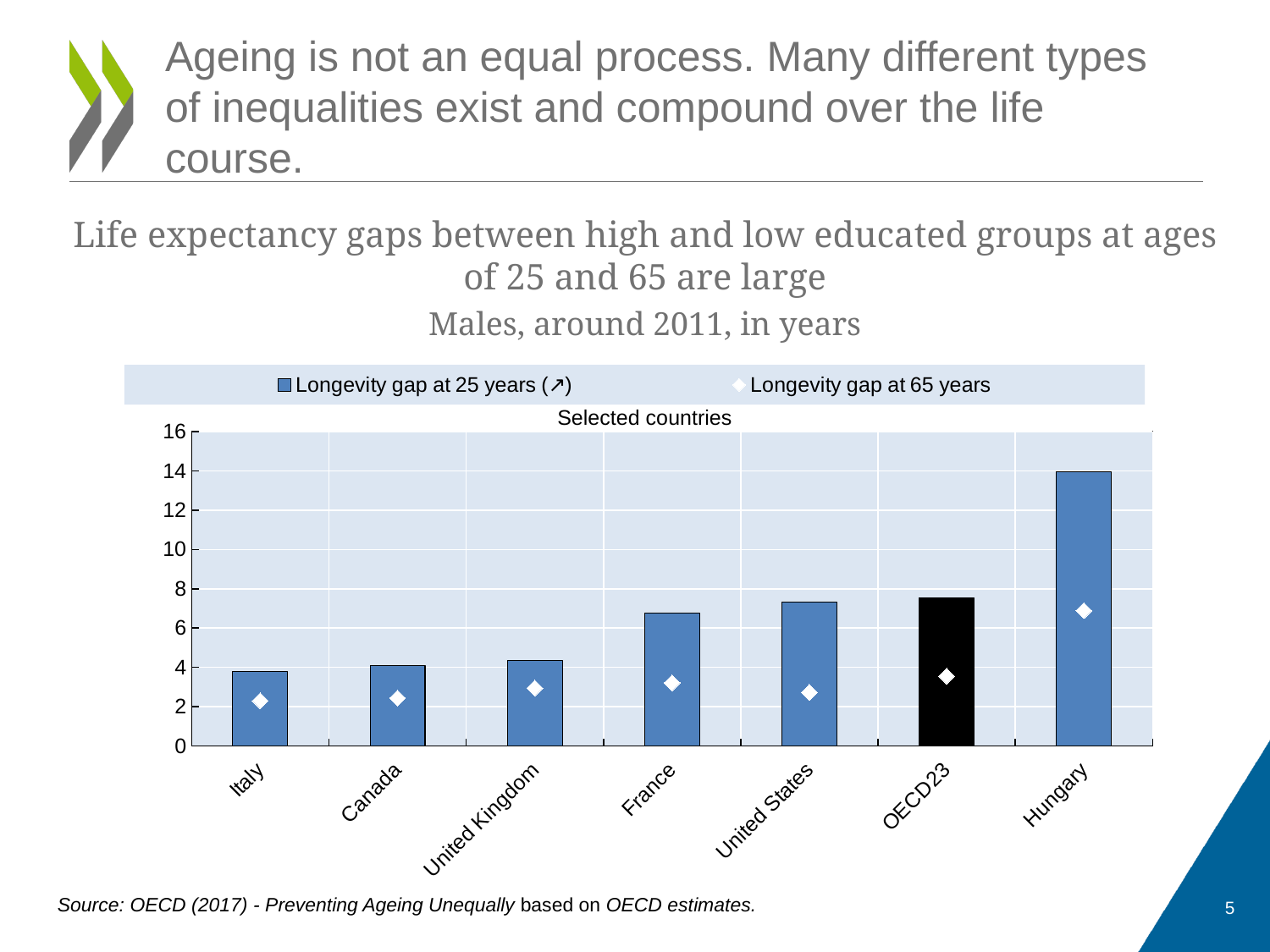
How many series does the chart's legend list? 2 What kind of chart is shown on the slide? bar chart Which has the larger longevity gap at 25 years, France or Hungary? Hungary Is the longevity gap at 25 years for the United States greater or less than 8? less Which country has the highest longevity gap at 65 years? Hungary Which country has the highest longevity gap at 25 years? Hungary Is the longevity gap at 25 years for Hungary greater or less than 12? greater Is the longevity gap at 25 years for France greater or less than 6? greater How many countries or groups are shown on the x axis of the chart? 7 Do the longevity gap at 25 years values rise or fall from left to right across the x axis? rise What is the title shown above the plot area of the chart? Selected countries